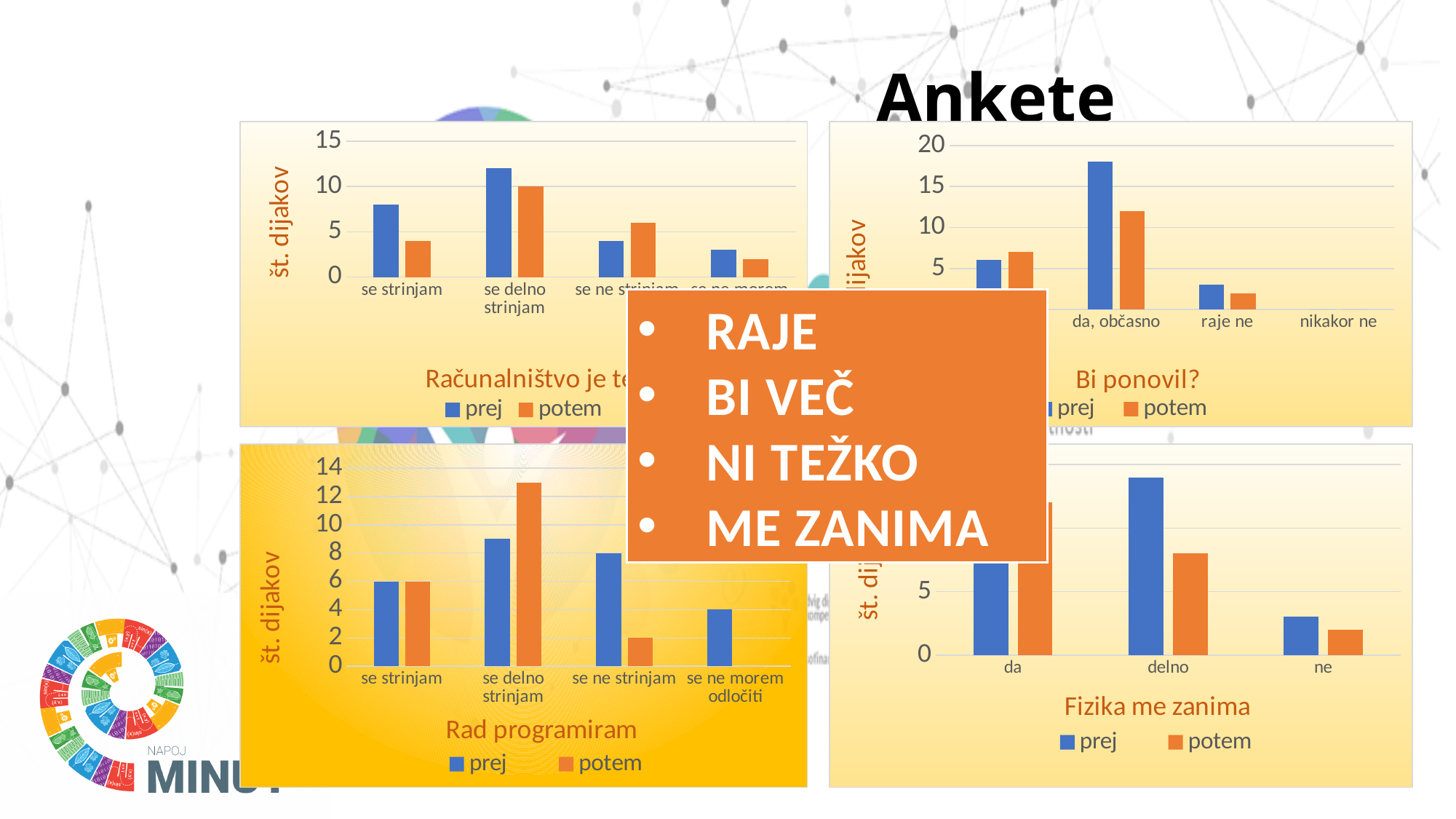
In the 'Fizika me zanima' chart, which is larger for 'delno': the 'prej' value or the 'potem' value? prej What kind of chart is the 'Rad programiram' chart? bar chart In the top-left chart, what is the 'potem' value for 'se delno strinjam'? 10 In the 'Bi ponovil?' chart, which category has the highest 'prej' value? da, občasno In the 'Bi ponovil?' chart, is the 'prej' value for 'da, občasno' greater or less than 15? greater In the 'Rad programiram' chart, what is the 'prej' value for 'se strinjam'? 6 In the 'Rad programiram' chart, what is the difference between the 'prej' and 'potem' values for 'se ne strinjam'? 6 In the 'Rad programiram' chart, what is the 'potem' value for 'se ne strinjam'? 2 How many series does the legend of the 'Rad programiram' chart list? 2 In the 'Rad programiram' chart, which category has the highest 'potem' value? se delno strinjam In the 'Rad programiram' chart, is the 'potem' value for 'se delno strinjam' greater or less than 12? greater How many categories are shown on the x axis of the 'Rad programiram' chart? 4